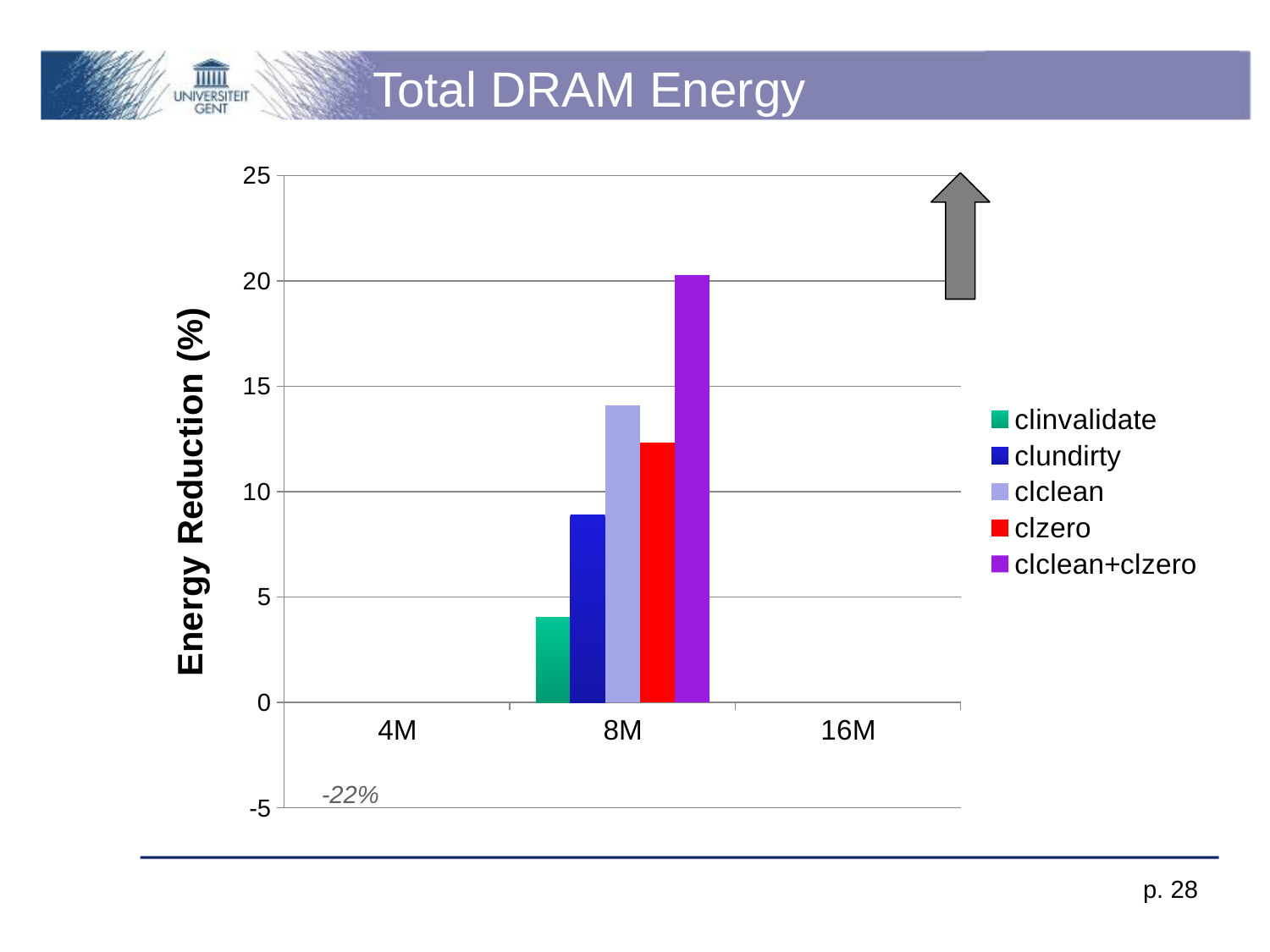
At 8M, which is larger: the value for clclean or the value for clzero? clclean At 8M, which series has the highest energy reduction? clclean+clzero What is the title of the y axis? Energy Reduction (%) At 8M, which series has the lowest energy reduction? clinvalidate What colour represents the clzero series in the legend? red How many categories are shown on the x axis? 3 At 8M, which is larger: the value for clundirty or the value for clzero? clzero Is the value for clinvalidate at 8M greater or less than 5? less What kind of chart is shown on the slide? bar chart Is the value for clundirty at 8M greater or less than 10? less How many series does the legend list? 5 Is the value for clclean+clzero at 8M greater or less than 15? greater